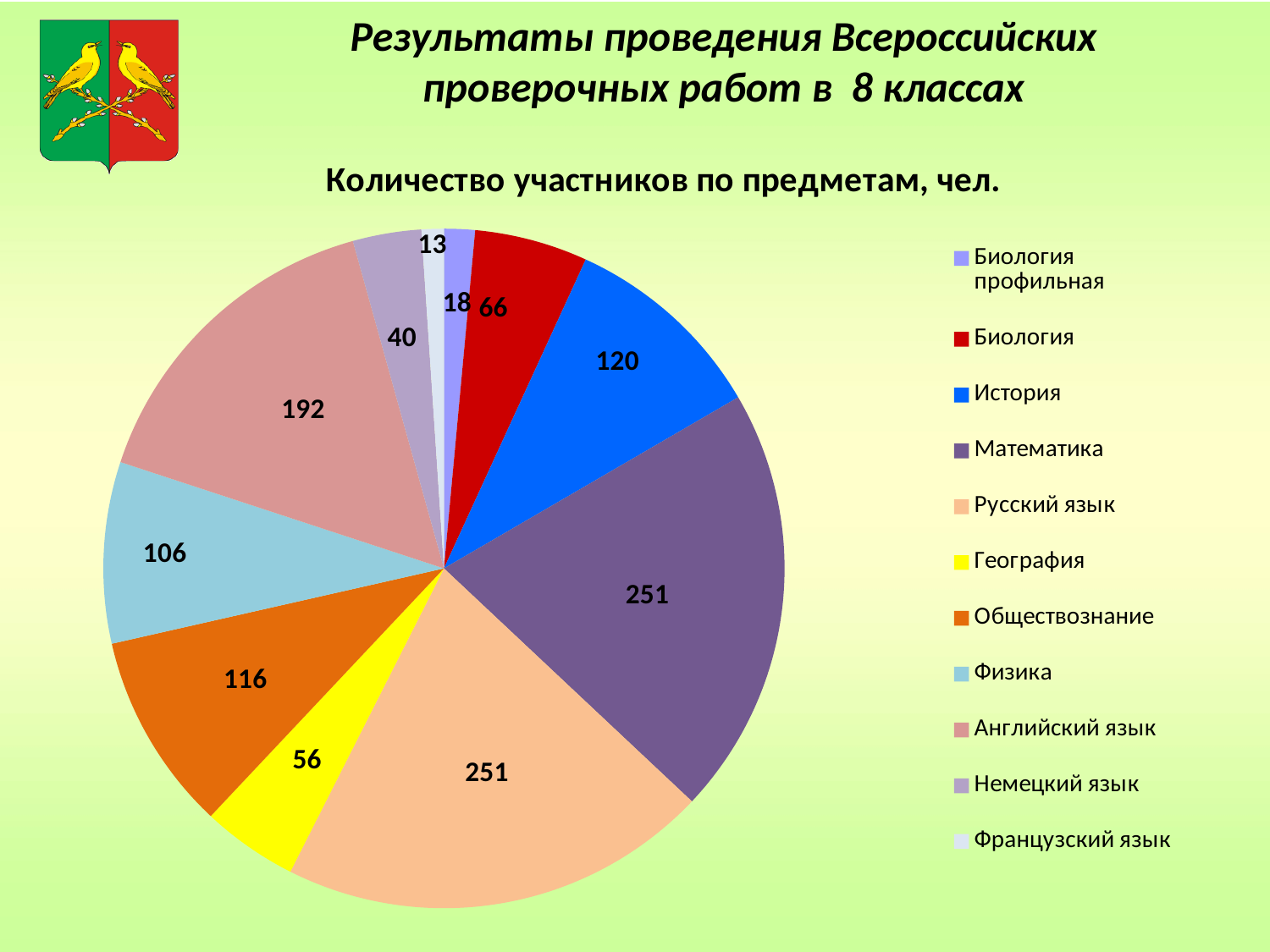
What is the value for Немецкий язык? 40 Which subject has the smallest number of participants? Французский язык What is the value for Физика? 106 What is the value for Биология профильная? 18 What is the title of the chart? Количество участников по предметам, чел. Which has more participants, Физика or Обществознание? Обществознание Which has more participants, Биология or География? Биология What is the difference between the values for Математика and История? 131 What is the difference between the values for Английский язык and Обществознание? 76 How many subjects (slices) does the pie chart show? 11 How many participants are shown for История? 120 What kind of chart is shown on the slide? pie chart